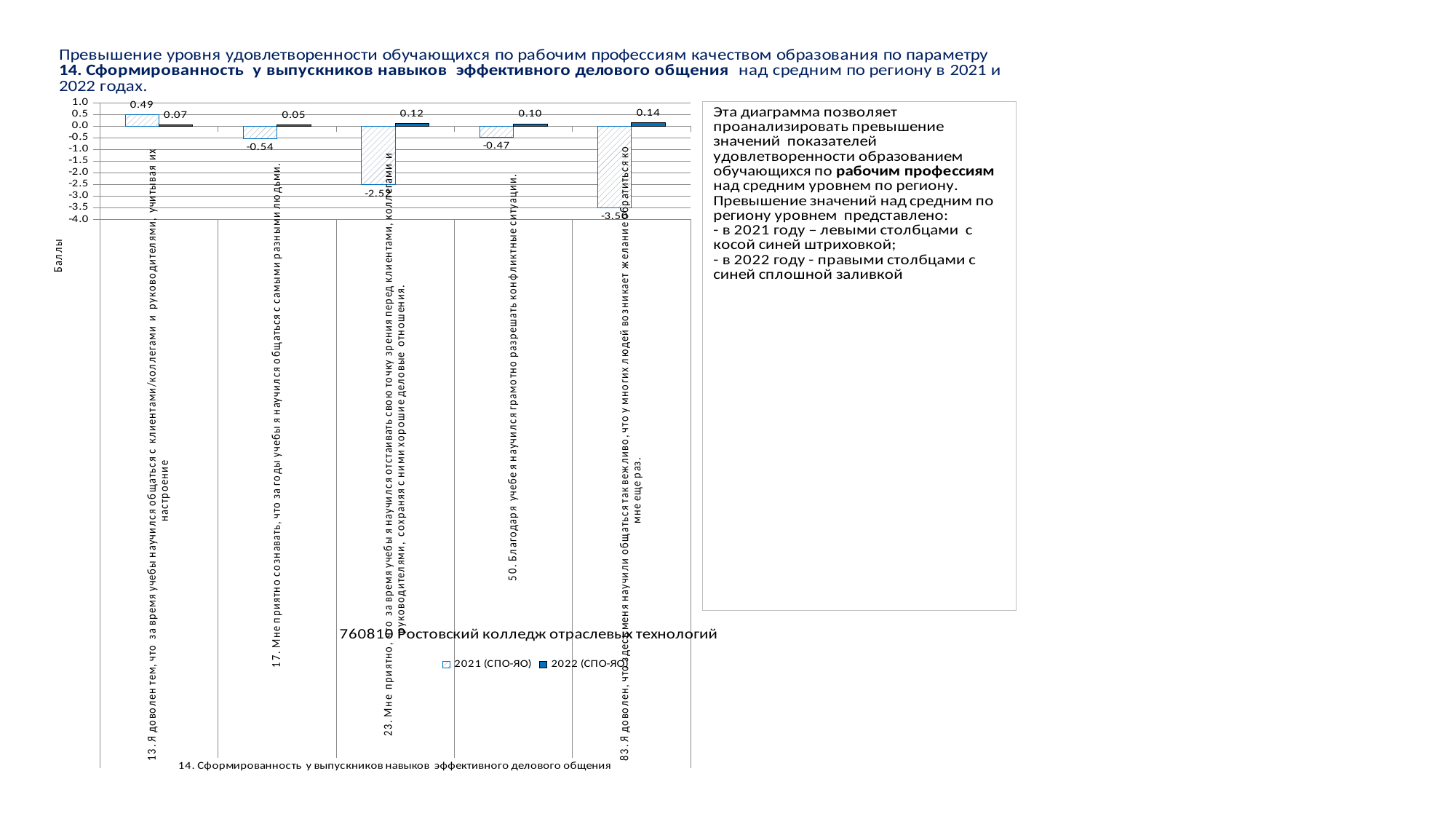
What is the 2022 (СПО-ЯО) value for item 50 ("Благодаря учебе я научился грамотно разрешать конфликтные ситуации")? 0.10 What is the 2021 (СПО-ЯО) value for item 13 ("Я доволен тем, что за время учебы научился общаться с клиентами/коллегами...")? 0.49 For item 17, which series has the larger value, 2021 (СПО-ЯО) or 2022 (СПО-ЯО)? 2022 (СПО-ЯО) For item 13, how much higher is the 2021 (СПО-ЯО) value than the 2022 (СПО-ЯО) value? 0.42 What is the 2022 (СПО-ЯО) value for item 83? 0.14 What is the 2022 (СПО-ЯО) value for item 13? 0.07 Which item has the highest 2022 (СПО-ЯО) value? 83 Which item has the lowest 2021 (СПО-ЯО) value? 83 What kind of chart is shown on the slide? bar chart What is the 2021 (СПО-ЯО) value for item 17 ("Мне приятно сознавать, что за годы учебы я научился общаться с самыми разными людьми")? -0.54 Is the 2021 (СПО-ЯО) value for item 83 greater or less than -3.0? less How many series does the legend list? 2